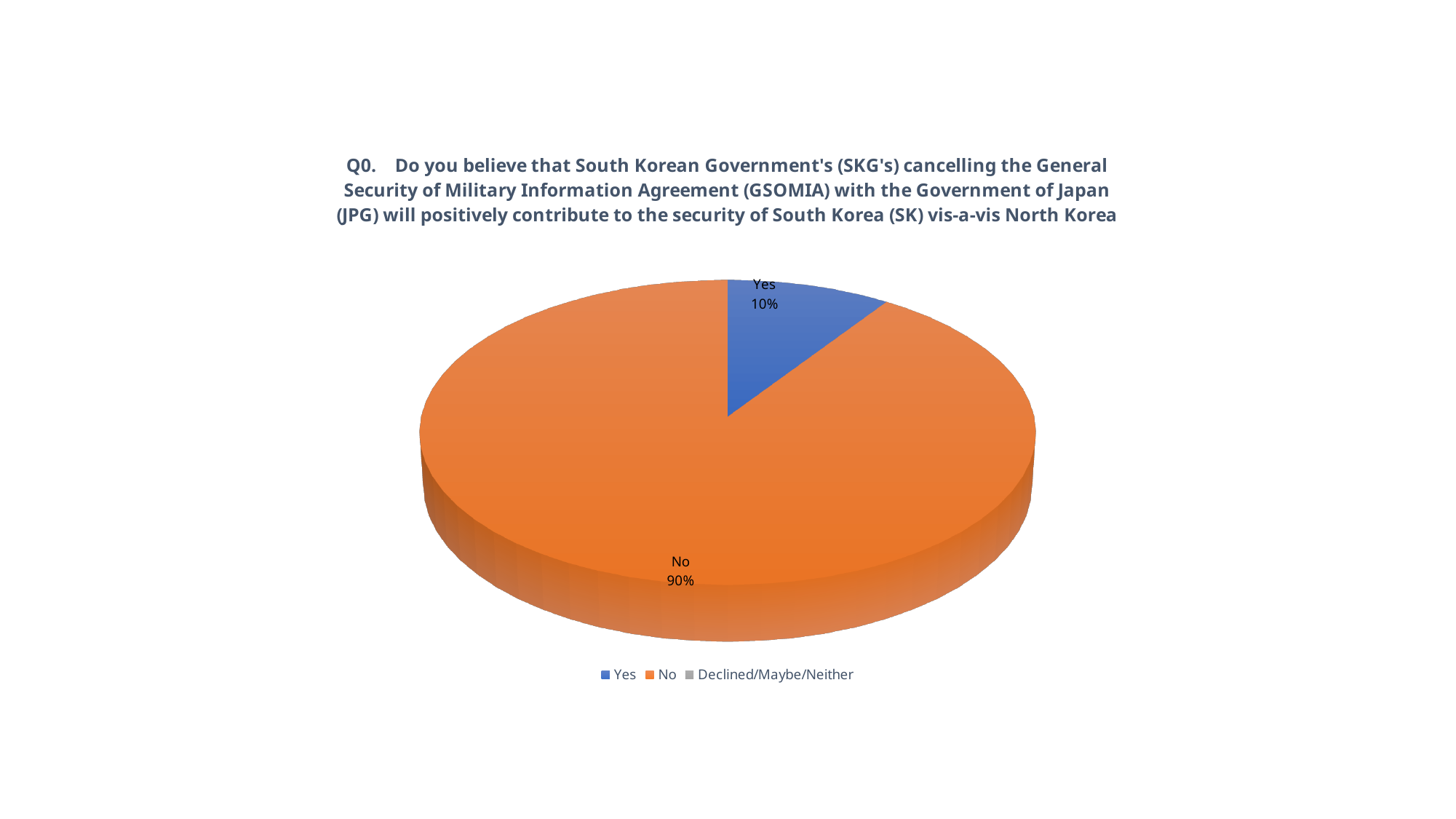
What colour is the slice for No? orange What is the difference in percentage points between the No share and the Yes share? 80 How many entries does the legend list? 3 What kind of chart is shown on the slide? pie chart Which of the two visible slices, Yes or No, is smaller? Yes How many slices are visibly labelled with a percentage on the pie? 2 What share of the pie is labelled "No"? 90% What is the third legend entry, after Yes and No? Declined/Maybe/Neither What share of the pie is labelled "Yes"? 10% Is the share for No larger or smaller than the share for Yes? larger Which response has the largest share of the pie? No